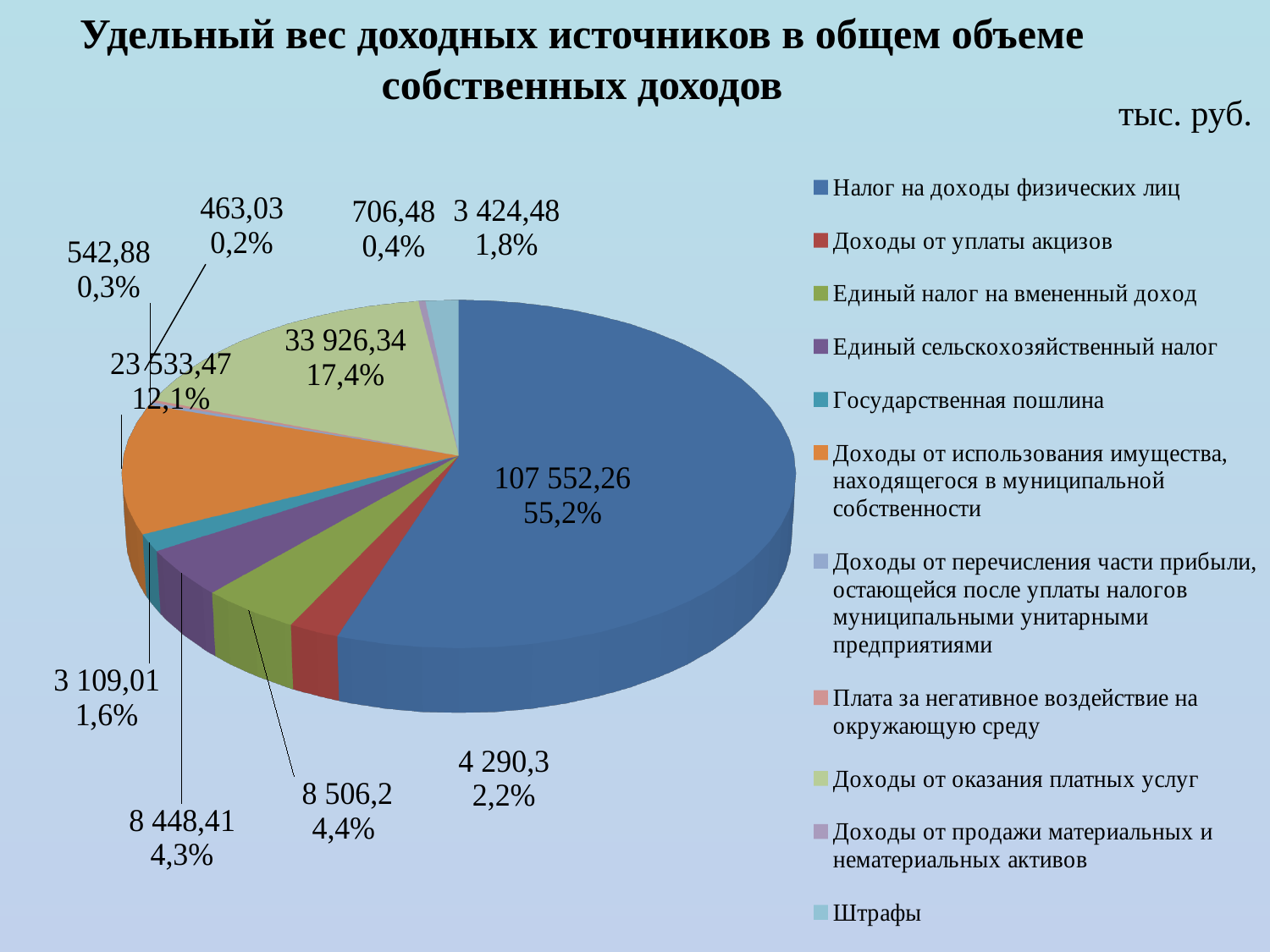
What is the value shown for Налог на доходы физических лиц? 107 552,26 What kind of chart is shown on the slide? pie chart Which category has the smallest slice of the pie? Плата за негативное воздействие на окружающую среду What share of the pie does Налог на доходы физических лиц represent? 55,2% Which category has the largest slice of the pie? Налог на доходы физических лиц What share of the pie does Доходы от использования имущества, находящегося в муниципальной собственности represent? 12,1% What is the difference in percentage points between the share of Доходы от оказания платных услуг and the share of Доходы от использования имущества, находящегося в муниципальной собственности? 5,3% What is the value shown for Доходы от оказания платных услуг? 33 926,34 Which is larger: the slice for Единый налог на вмененный доход or the slice for Доходы от уплаты акцизов? Единый налог на вмененный доход How many categories does the legend of the pie chart list? 11 What share of the pie does Штрафы represent? 1,8% What unit is indicated for the values on the chart? тыс. руб.